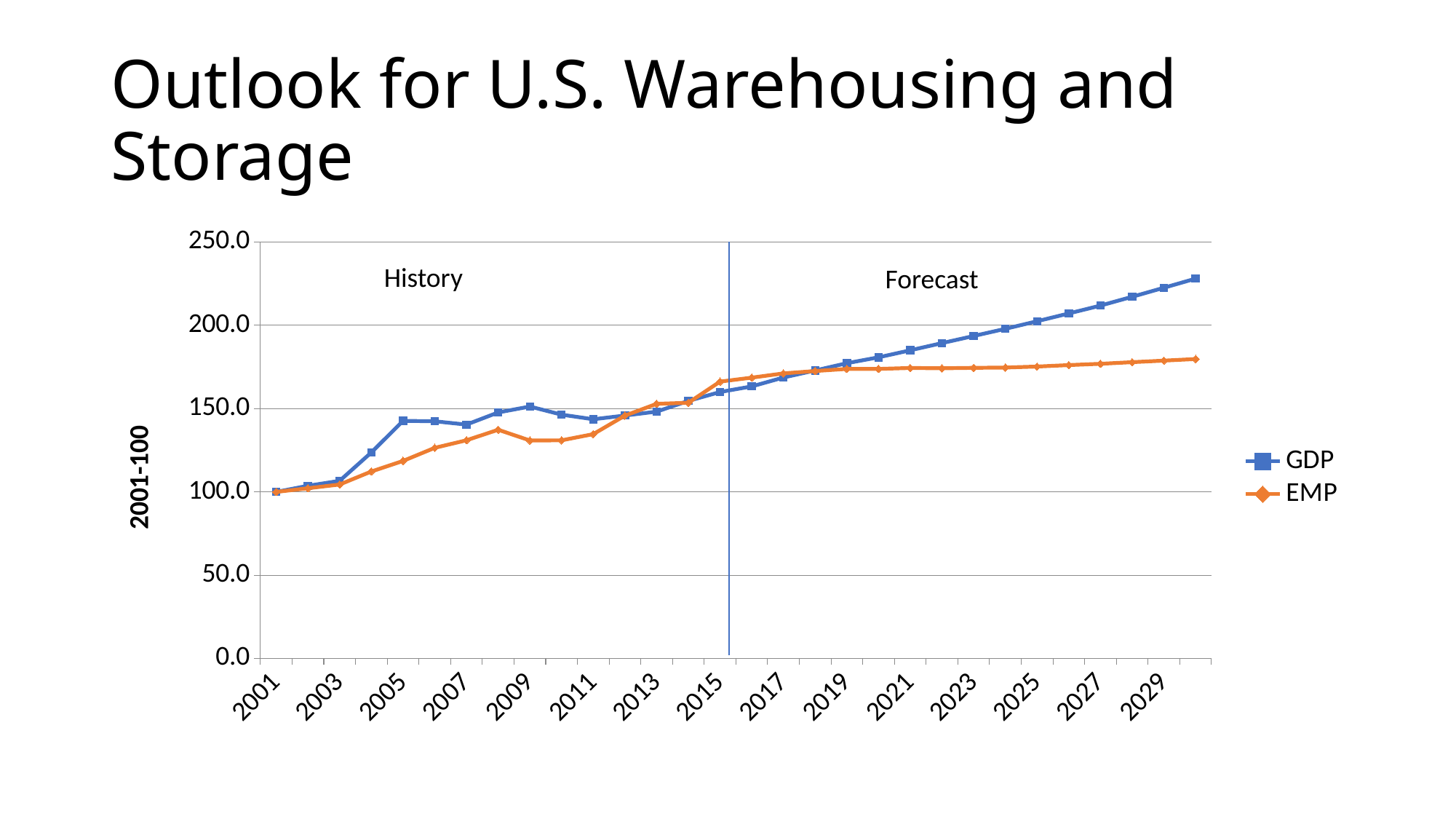
What two period labels are written inside the plot area, separated by the vertical line? History and Forecast Is the EMP value for 2009 greater or less than 150.0? less Does the GDP series rise or fall across the Forecast period? rises What is the value of the EMP series in 2001? 100.0 What are the two series named in the legend? GDP and EMP In 2029, which series has the higher value, GDP or EMP? GDP What is the value of the GDP series in 2001? 100.0 How many series does the legend list? 2 What kind of chart is shown on the slide? line chart Is the GDP value for 2029 greater or less than 200.0? greater Is the EMP value for 2029 greater or less than 200.0? less In 2005, which series has the higher value, GDP or EMP? GDP